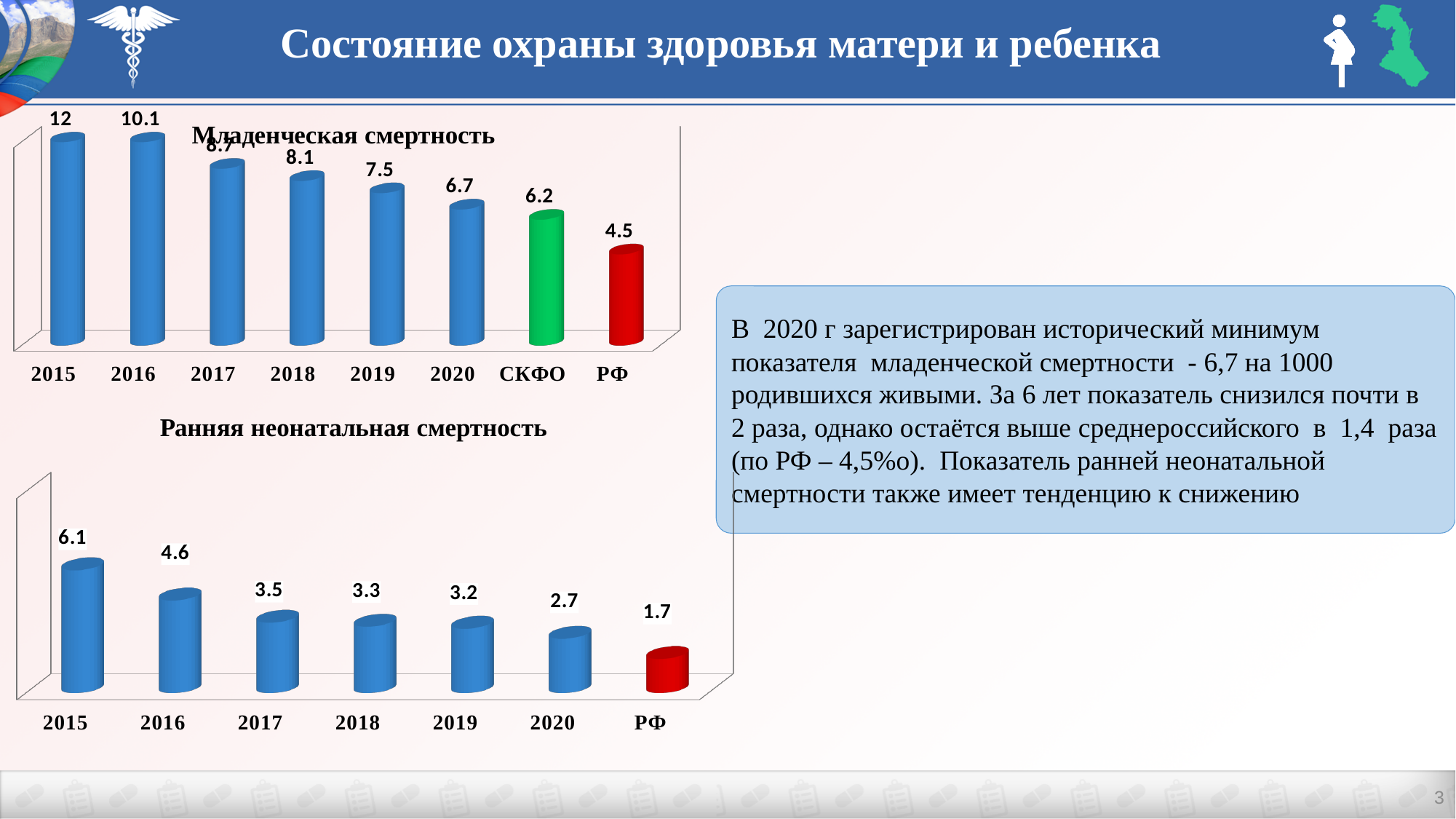
In the chart titled "Младенческая смертность", what is the value for 2020? 6.7 In the chart titled "Младенческая смертность", which category has the lowest value? РФ In the chart titled "Ранняя неонатальная смертность", do the values rise or fall from 2015 to 2020? fall In the chart titled "Ранняя неонатальная смертность", which year has the highest value? 2015 In the chart titled "Младенческая смертность", what is the value for 2015? 12 In the chart titled "Младенческая смертность", how many bars are plotted? 8 In the chart titled "Младенческая смертность", which is larger, the value for СКФО or the value for РФ? СКФО What kind of chart is the chart titled "Ранняя неонатальная смертность"? bar chart In the chart titled "Ранняя неонатальная смертность", what is the difference between the 2020 value and the РФ value? 1 In the chart titled "Ранняя неонатальная смертность", what is the value for 2016? 4.6 In the chart titled "Младенческая смертность", what is the value for РФ? 4.5 In the chart titled "Младенческая смертность", what is the difference between the 2015 value and the 2020 value? 5.3